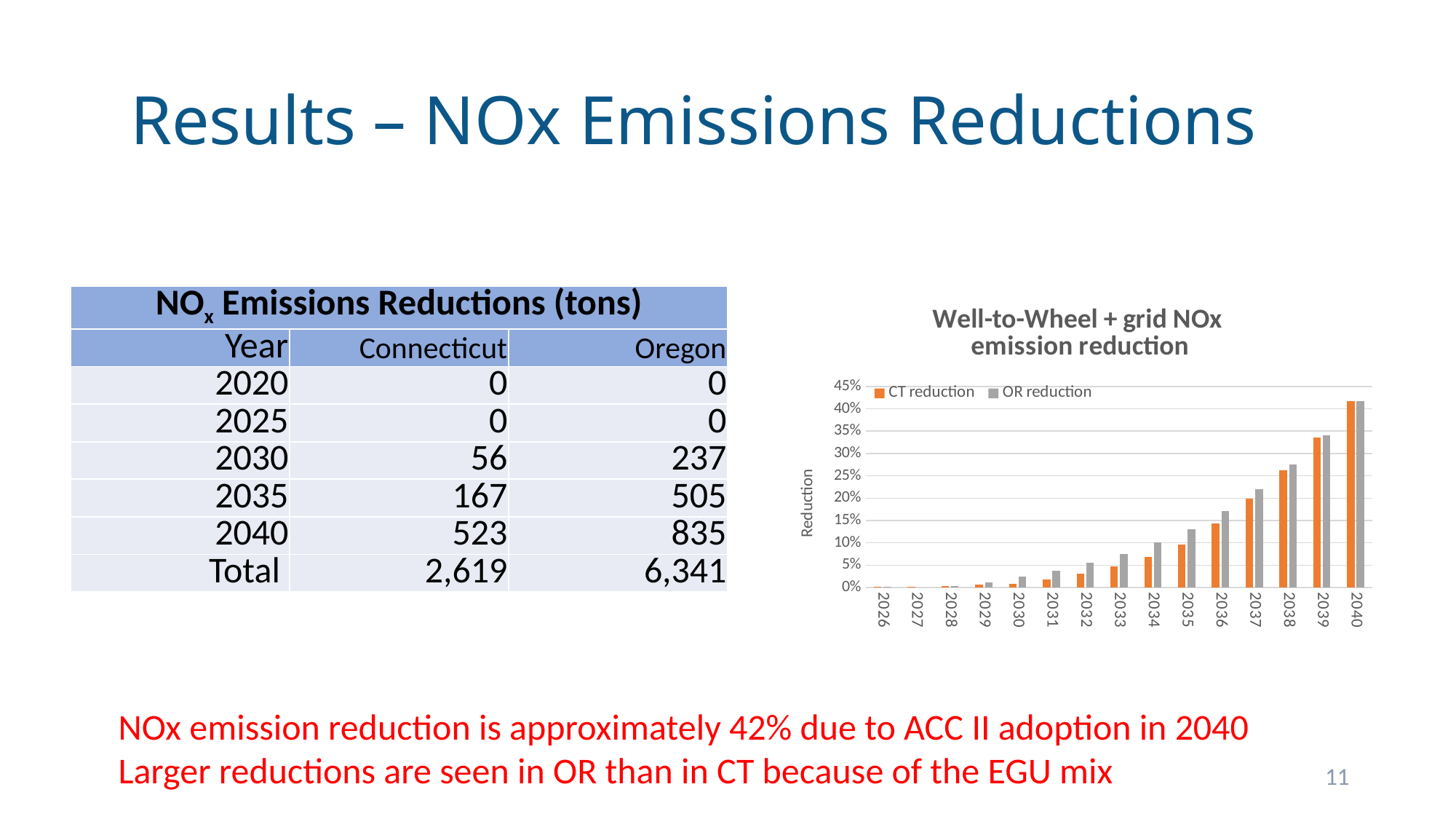
Do the values in the chart rise or fall from 2026 to 2040? rise What kind of chart is shown on the slide? bar chart How many series does the legend of the chart list? 2 In which year is the CT reduction highest? 2040 What is the title of the chart? Well-to-Wheel + grid NOx emission reduction In 2035, which is larger, the CT reduction or the OR reduction? OR reduction Is the OR reduction for 2036 greater or less than 15%? greater Which colour represents the OR reduction series in the chart? gray Is the CT reduction for 2040 greater or less than 40%? greater How many years are shown along the x axis of the chart? 15